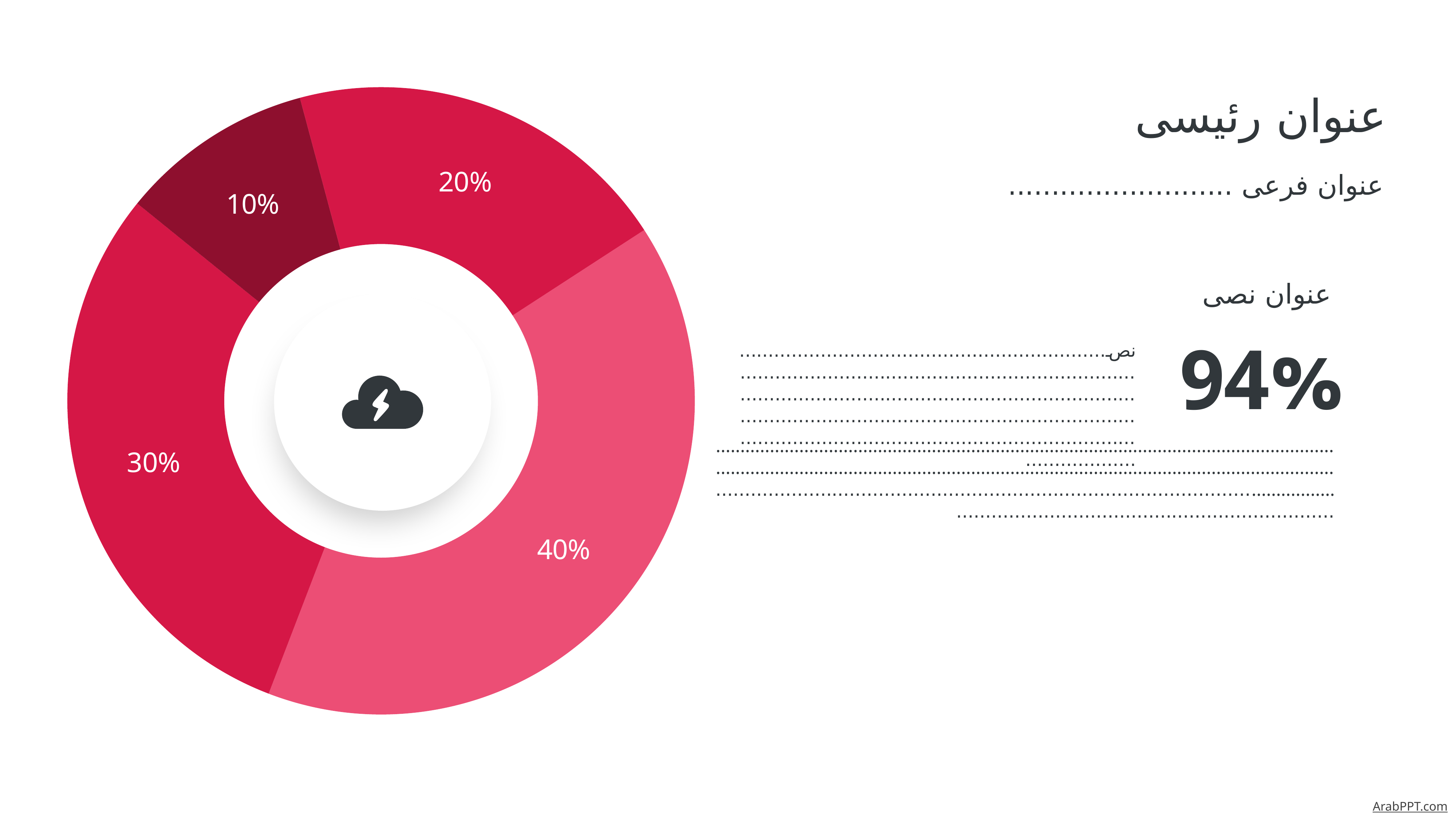
What is the largest percentage shown on the donut chart? 40% Which is larger on the donut chart, the 30% slice or the 20% slice? The 30% slice What percentage is labelled on the slice on the left side of the donut chart? 30% How many slices does the donut chart have? 4 What icon is shown in the centre of the donut chart? A cloud with a lightning bolt What percentage is labelled on the lightest pink slice of the donut chart? 40% What is the smallest percentage shown on the donut chart? 10% What is the difference between the largest and smallest slices of the donut chart? 30% What do the four slice percentages on the donut chart add up to? 100% What percentage is labelled on the slice at the top of the donut chart? 20% What kind of chart is shown on the slide? Donut (pie) chart What percentage is labelled on the darkest (maroon) slice of the donut chart? 10%